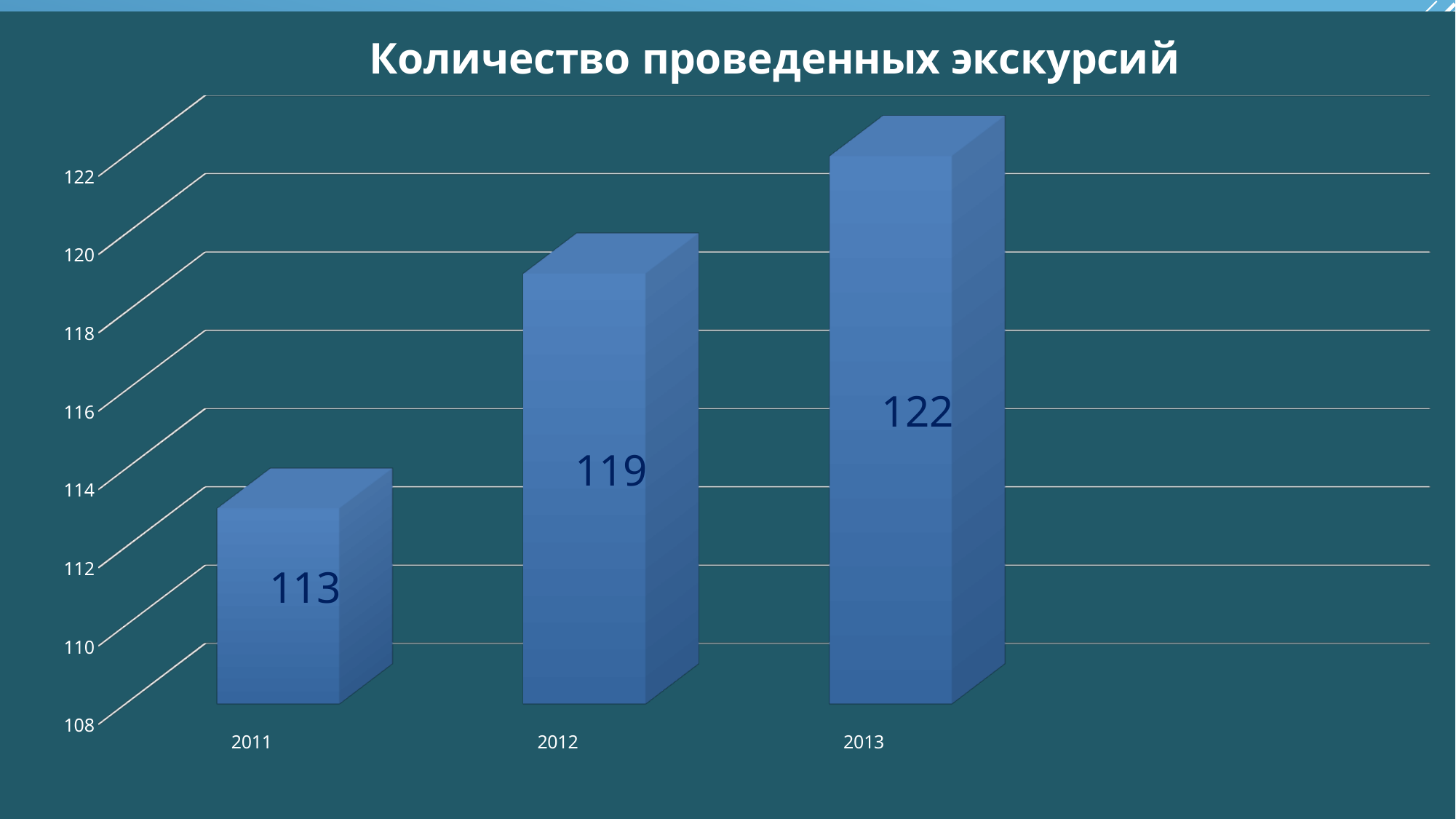
Which year has the lowest value? 2011 What is the difference between the values for 2012 and 2011? 6 Do the values rise or fall from 2011 to 2013? rise What kind of chart is this? bar chart How many years are shown on the chart? 3 What is the value for 2012? 119 Which year has the highest value? 2013 Is the value for 2011 greater or less than 116? less What is the value for 2011? 113 What is the value for 2013? 122 Which is larger, the value for 2012 or the value for 2013? 2013 What is the difference between the values for 2013 and 2011? 9